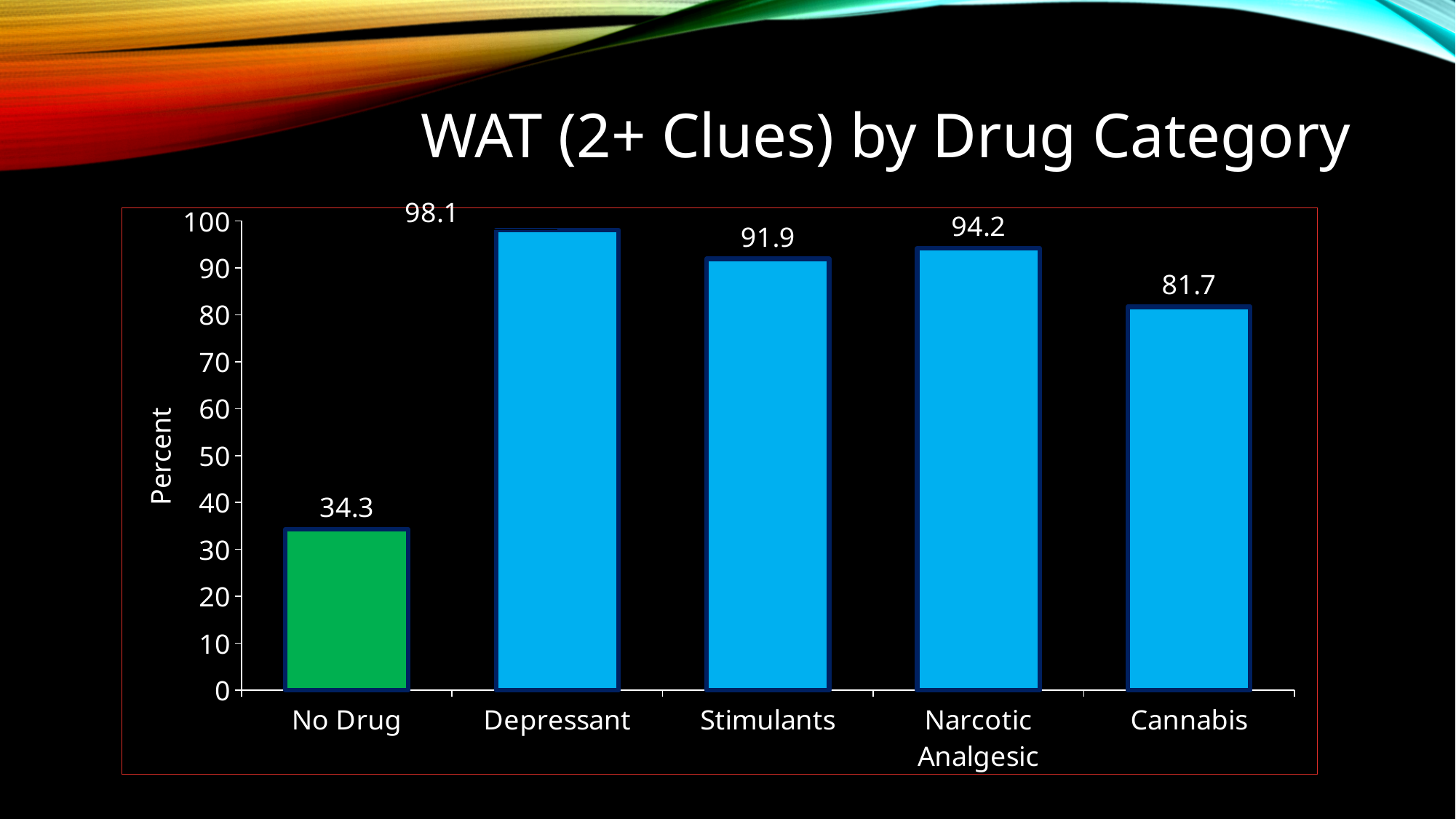
What kind of chart is shown on the slide? Bar chart What is the value for No Drug? 34.3 How many drug categories are shown on the chart? 5 What is the value for Depressant? 98.1 What is the difference between the values for Narcotic Analgesic and Stimulants? 2.3 What is the value for Narcotic Analgesic? 94.2 Which category has the lowest value? No Drug What is the value for Cannabis? 81.7 Which category has the highest value? Depressant What is the title of the chart? WAT (2+ Clues) by Drug Category What is the difference between the values for Depressant and No Drug? 63.8 Which is larger, the value for Stimulants or the value for Cannabis? Stimulants